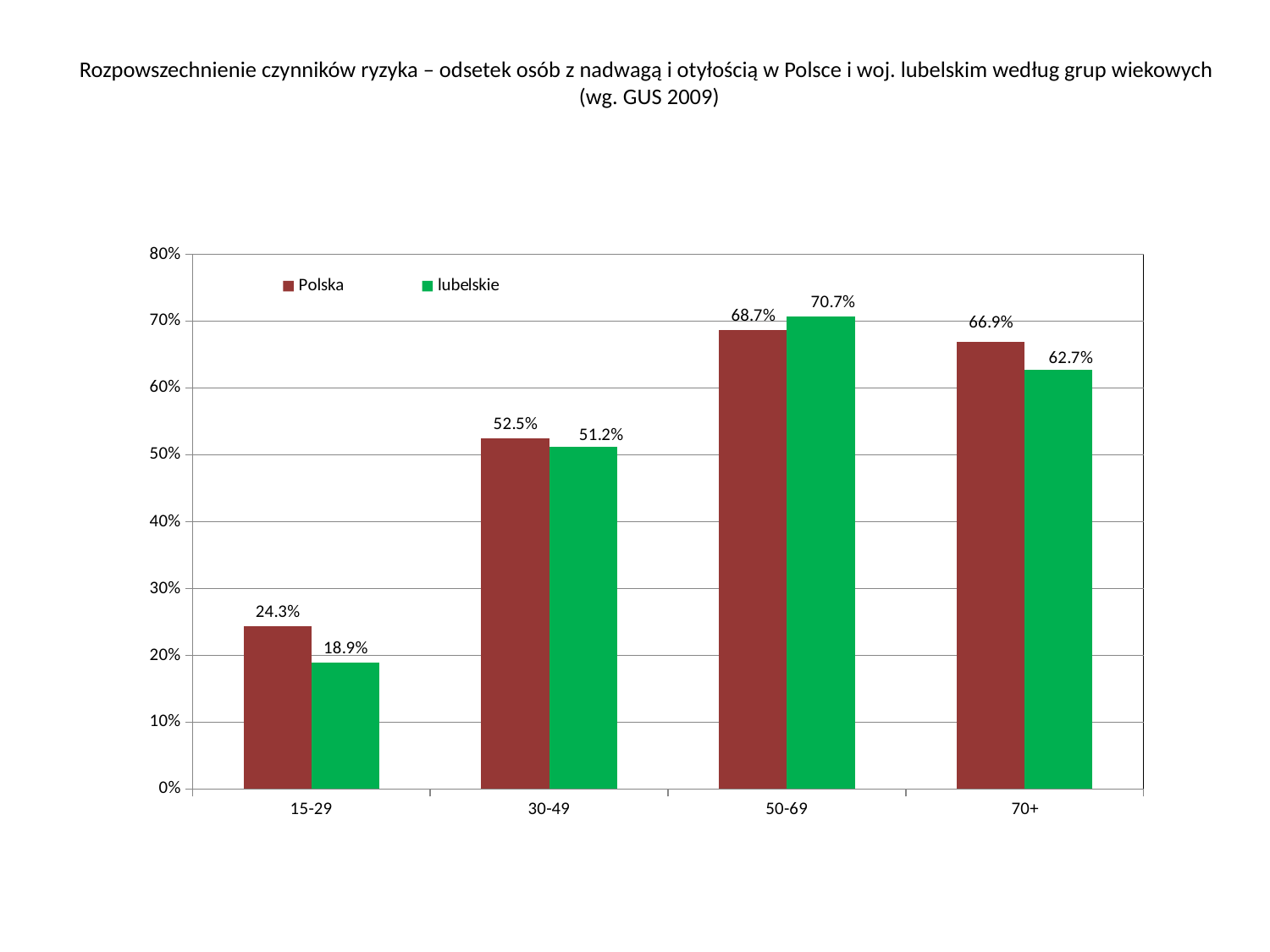
How many age groups are shown on the x axis? 4 How many series does the legend list? 2 Which age group has the highest value for lubelskie? 50-69 In the 70+ age group, which is larger: Polska or lubelskie? Polska What is the value for lubelskie in the 70+ age group? 62.7% What is the difference between Polska and lubelskie in the 15-29 age group? 5.4% Is the value for Polska in the 50-69 age group greater or less than 60%? greater What is the difference between lubelskie and Polska in the 50-69 age group? 2.0% Which age group has the lowest value for Polska? 15-29 What is the value for Polska in the 30-49 age group? 52.5% What is the value for lubelskie in the 15-29 age group? 18.9% What kind of chart is shown on the slide? bar chart